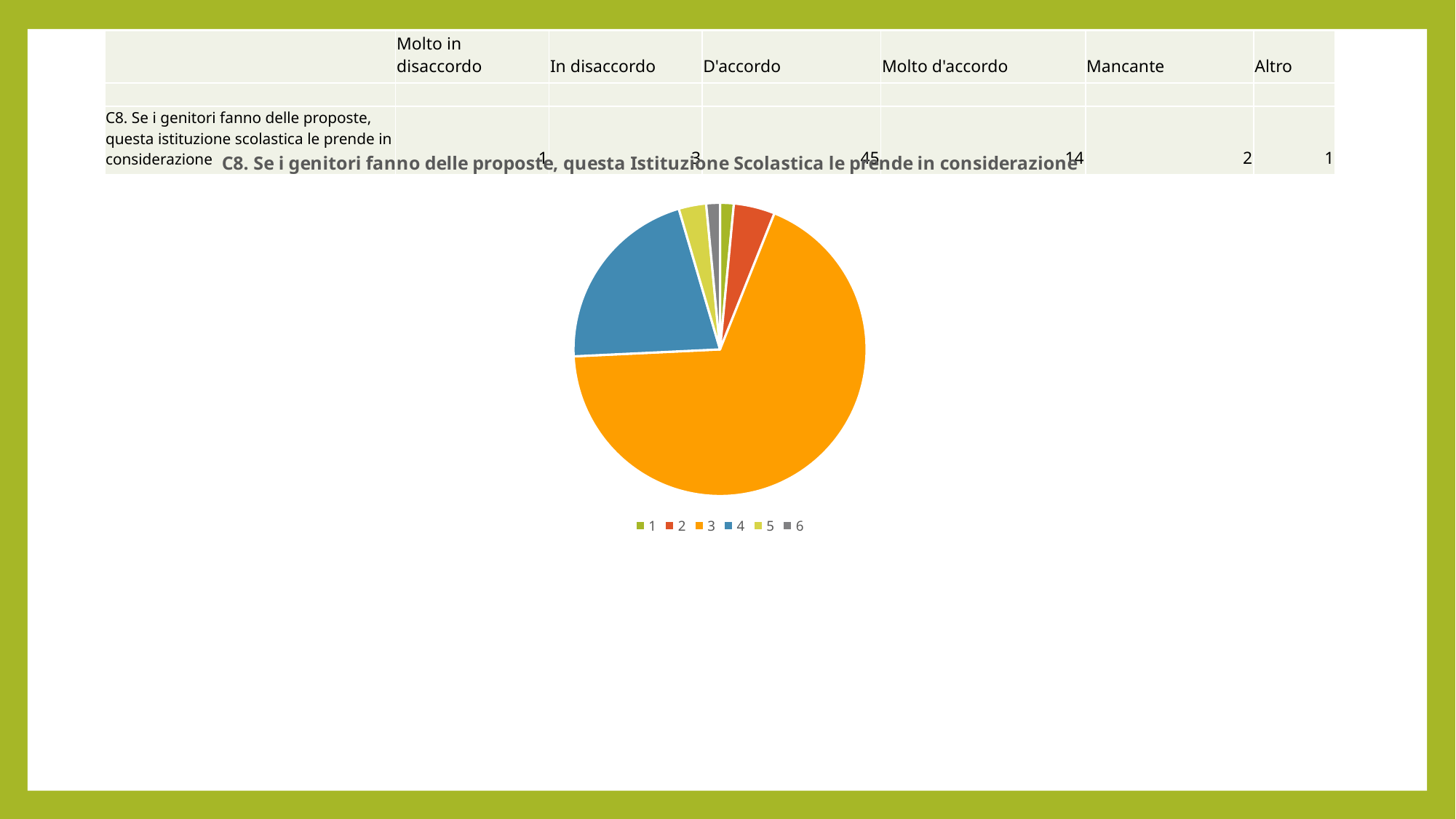
According to the table on the slide, what is the value for Molto d'accordo? 14 Which legend entry corresponds to the largest slice of the pie chart? 3 According to the table on the slide, what is the value for D'accordo? 45 Is the slice for legend entry 4 larger or smaller than the slice for legend entry 2? larger What is the title of the pie chart? C8. Se i genitori fanno delle proposte, questa Istituzione Scolastica le prende in considerazione Does the largest slice of the pie chart cover more or less than half of the pie? more What colour is the largest slice of the pie chart? orange Is the slice for legend entry 3 larger or smaller than the slice for legend entry 4? larger Which legend entry corresponds to the second-largest slice of the pie chart? 4 According to the table on the slide, what is the difference between the values for D'accordo and Molto d'accordo? 31 What kind of chart is shown on the slide? pie chart How many entries does the pie chart's legend list? 6